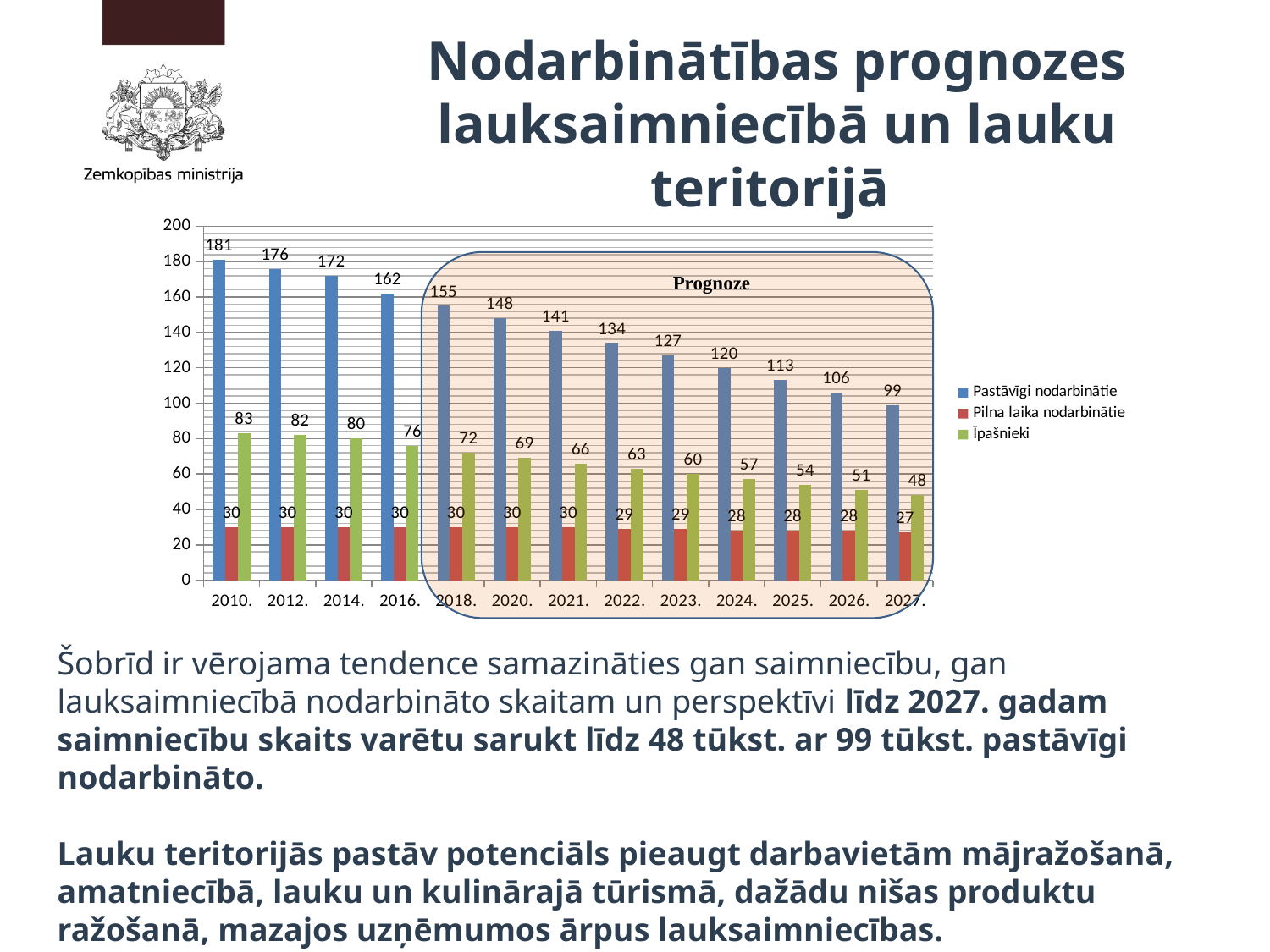
Is the value for Pastāvīgi nodarbinātie in 2022. greater or less than 140? less What is the value for Pilna laika nodarbinātie in 2024.? 28 Do the values for Pastāvīgi nodarbinātie rise or fall from 2010. to 2027.? fall In which year is the value for Īpašnieki the highest? 2010. How many series does the legend list? 3 What is the value for Īpašnieki in 2027.? 48 In which year is the value for Pastāvīgi nodarbinātie the lowest? 2027. What kind of chart is shown on the slide? bar chart How many years are shown on the x axis? 13 What is the difference between the Pastāvīgi nodarbinātie values for 2010. and 2027.? 82 What is the value for Pastāvīgi nodarbinātie in 2010.? 181 Which is larger: Īpašnieki in 2018. or Īpašnieki in 2023.? 2018.